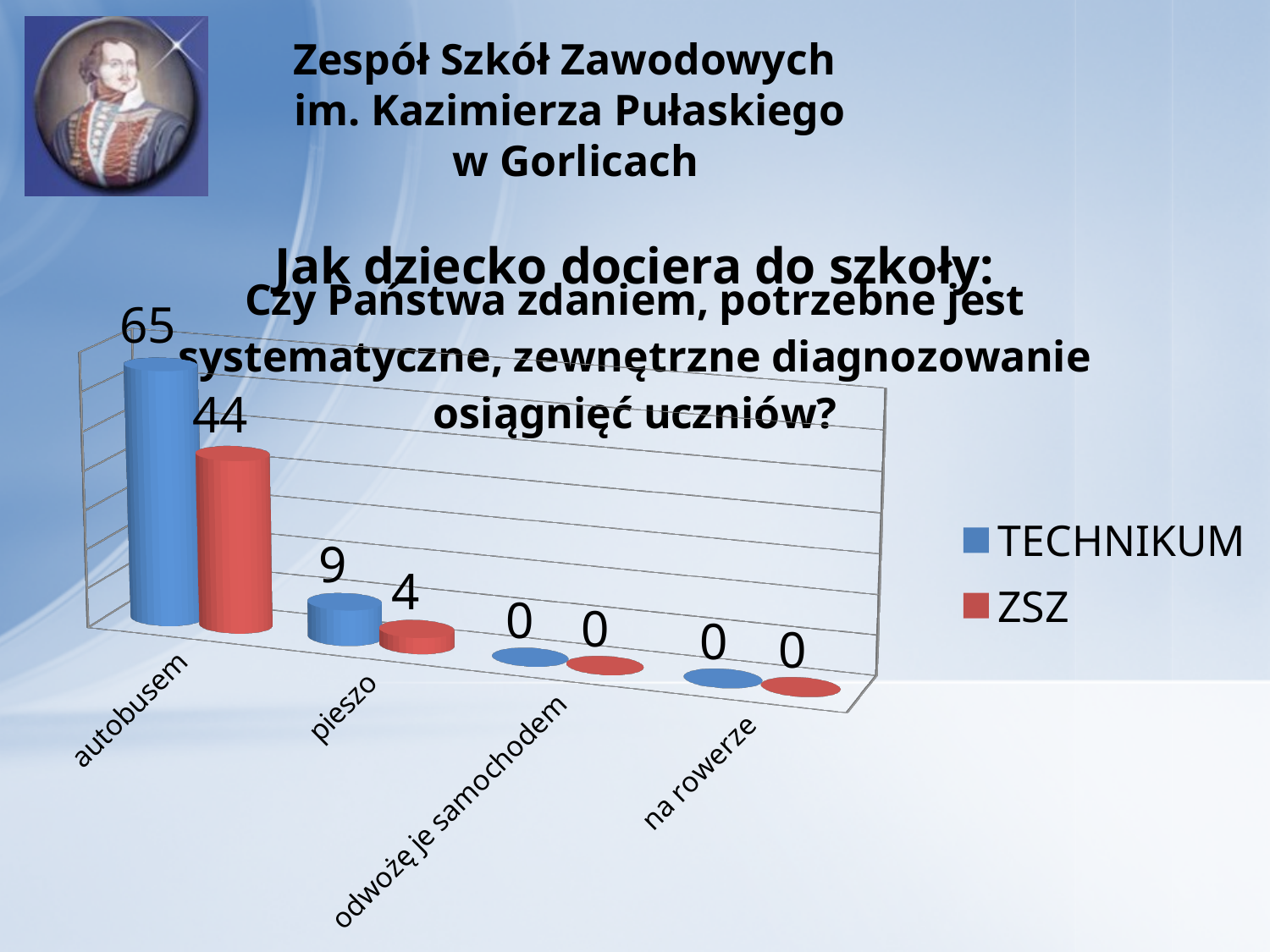
What is the difference between the TECHNIKUM and ZSZ values for autobusem? 21 What kind of chart is shown on the slide? bar chart What is the TECHNIKUM value for autobusem? 65 Which is larger for pieszo, the TECHNIKUM value or the ZSZ value? TECHNIKUM How many categories are shown on the x axis? 4 What is the ZSZ value for pieszo? 4 Which category has the highest TECHNIKUM value? autobusem How many series does the legend list? 2 What is the ZSZ value for autobusem? 44 What is the difference between the TECHNIKUM and ZSZ values for pieszo? 5 What is the TECHNIKUM value for na rowerze? 0 What is the TECHNIKUM value for pieszo? 9